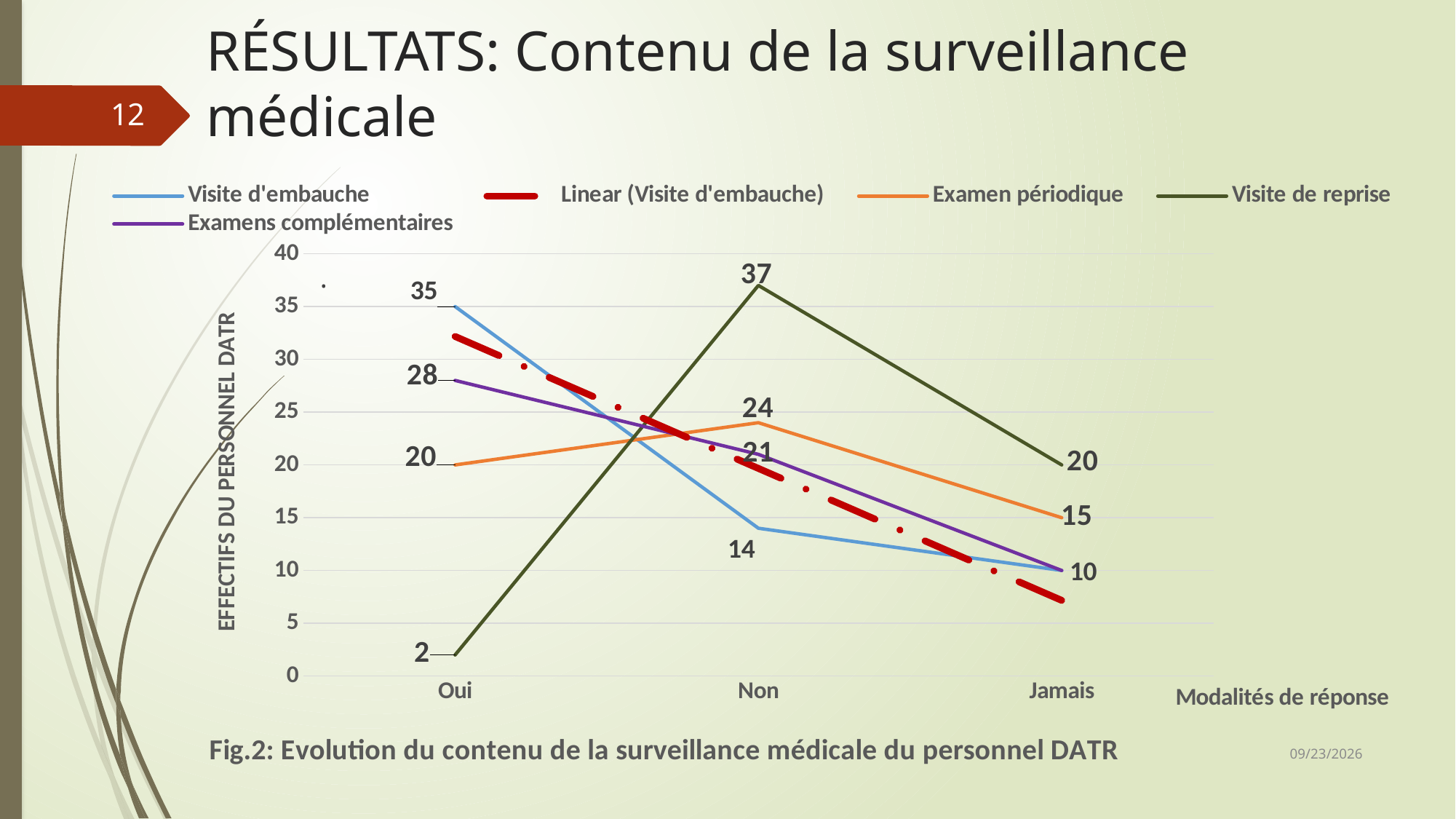
What is the difference between the Visite d'embauche values at Oui and Non? 21 What kind of chart is shown on the slide? Line chart What is the value for Visite de reprise at Non? 37 What is the value for Examens complémentaires at Oui? 28 How many response categories are shown on the x axis? 3 For the Visite de reprise series, which response category has the lowest value? Oui What is the value for Visite d'embauche at Oui? 35 At Non, which is larger: Examen périodique or Visite d'embauche? Examen périodique Does the Visite d'embauche series rise or fall from Oui to Jamais? Fall How many entries does the legend list? 5 For the Visite de reprise series, which response category has the highest value? Non What is the value for Examen périodique at Jamais? 15